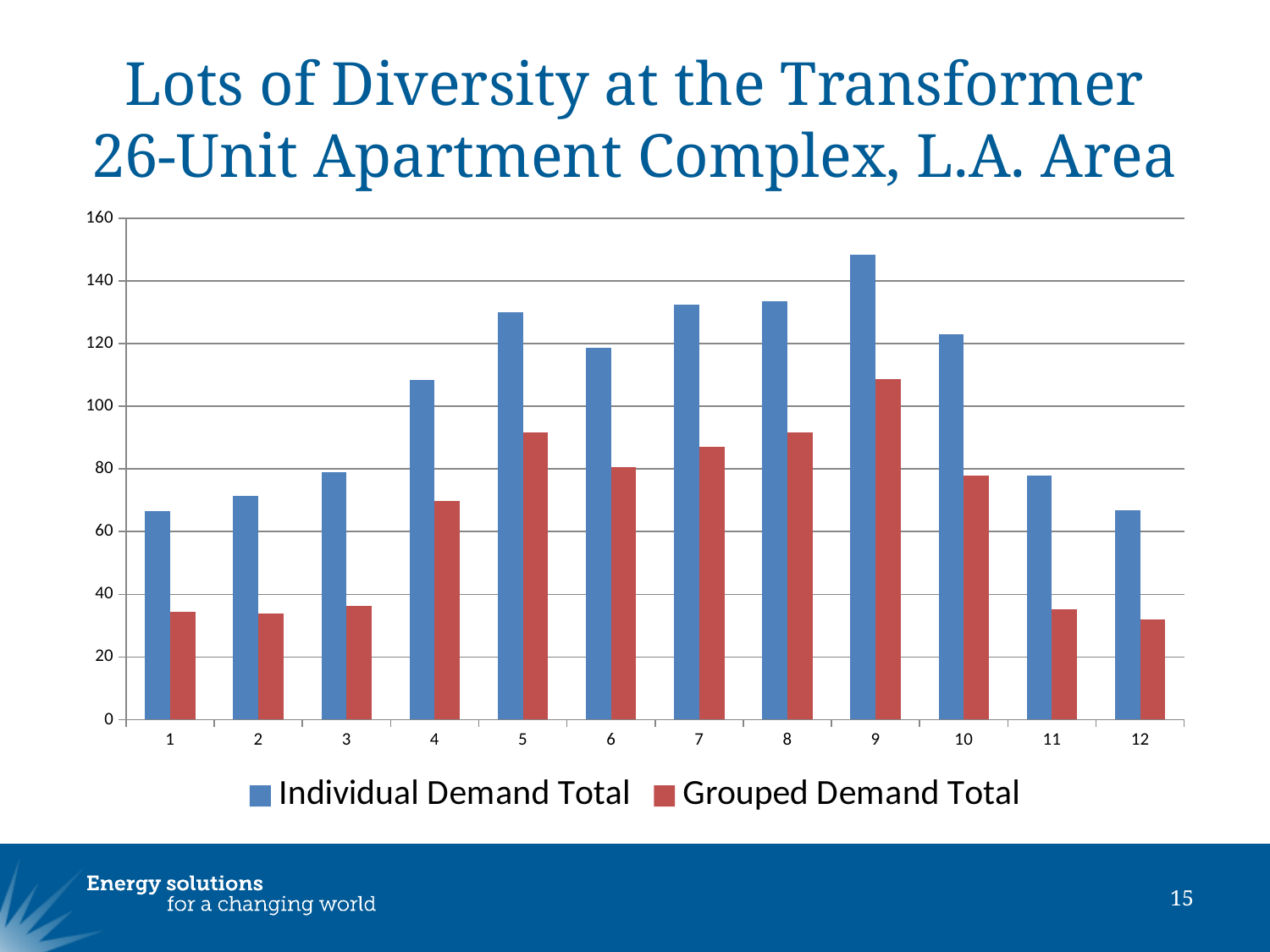
Which series is shown in red? Grouped Demand Total What kind of chart is shown on the slide? bar chart Which category has the highest Grouped Demand Total? 9 Which category has the highest Individual Demand Total? 9 Is the Individual Demand Total for category 9 greater or less than 140? greater Is the Grouped Demand Total for category 1 greater or less than 40? less Is the Individual Demand Total for category 4 greater or less than 100? greater Which is larger, the Individual Demand Total for category 5 or for category 6? category 5 How many series does the legend list? 2 How many categories are shown on the x axis? 12 Do the Individual Demand Total values rise or fall from category 9 to category 12? fall